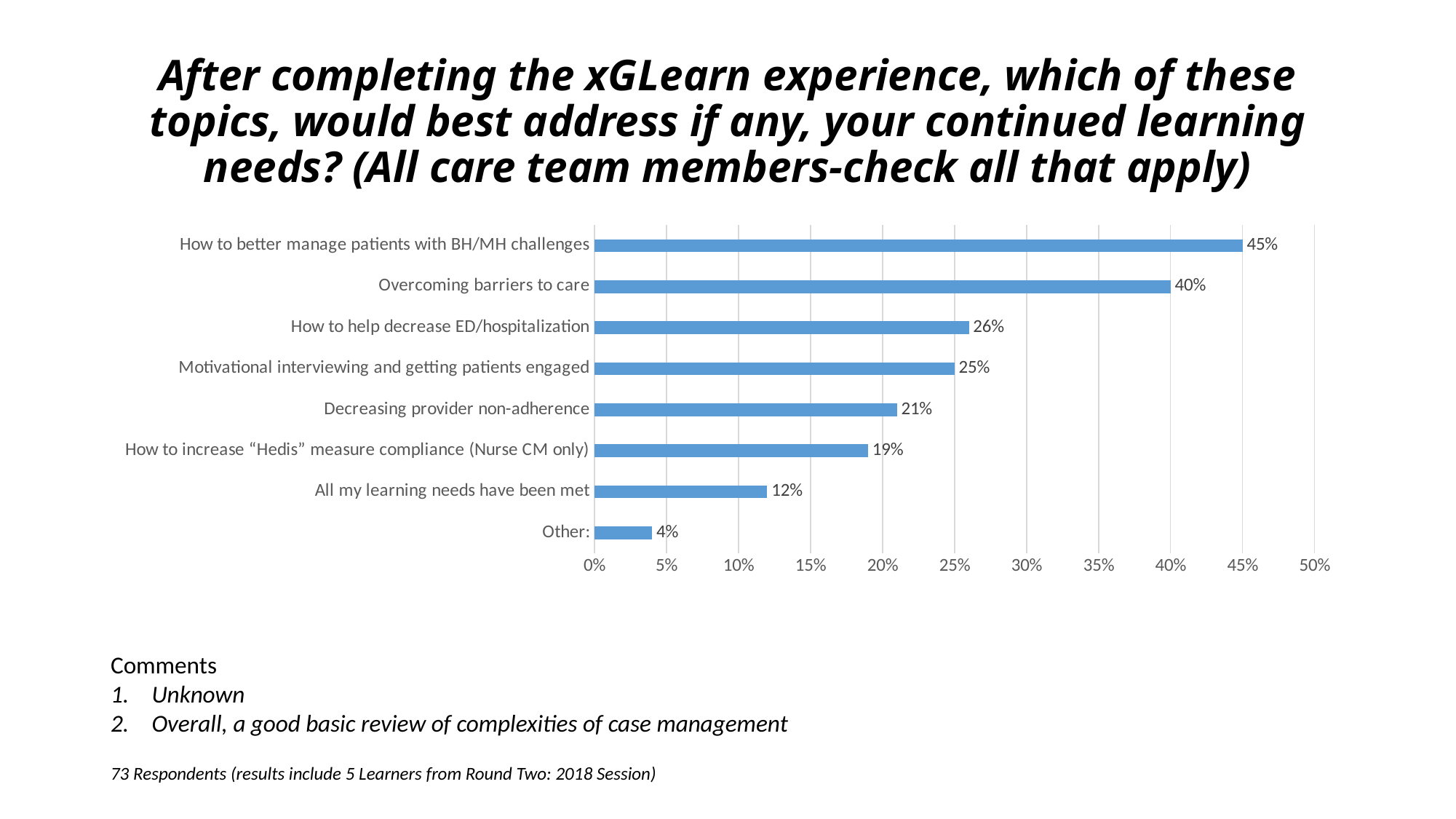
What is the value shown for "How to increase "Hedis" measure compliance (Nurse CM only)"? 19% Which category has the lowest percentage? Other: Is the value for "How to help decrease ED/hospitalization" greater or less than 30%? less Which topic has the highest percentage? How to better manage patients with BH/MH challenges Which has a higher value: "Decreasing provider non-adherence" or "Motivational interviewing and getting patients engaged"? Motivational interviewing and getting patients engaged What is the maximum value shown on the x axis of the chart? 50% What type of chart is shown on the slide? Bar chart What percentage of respondents selected "Overcoming barriers to care"? 40% What is the difference between the percentages for "How to better manage patients with BH/MH challenges" and "Overcoming barriers to care"? 5% What is the difference between the values for "Decreasing provider non-adherence" and "Other:"? 17% What percentage is shown for "All my learning needs have been met"? 12% How many categories are shown in the chart? 8